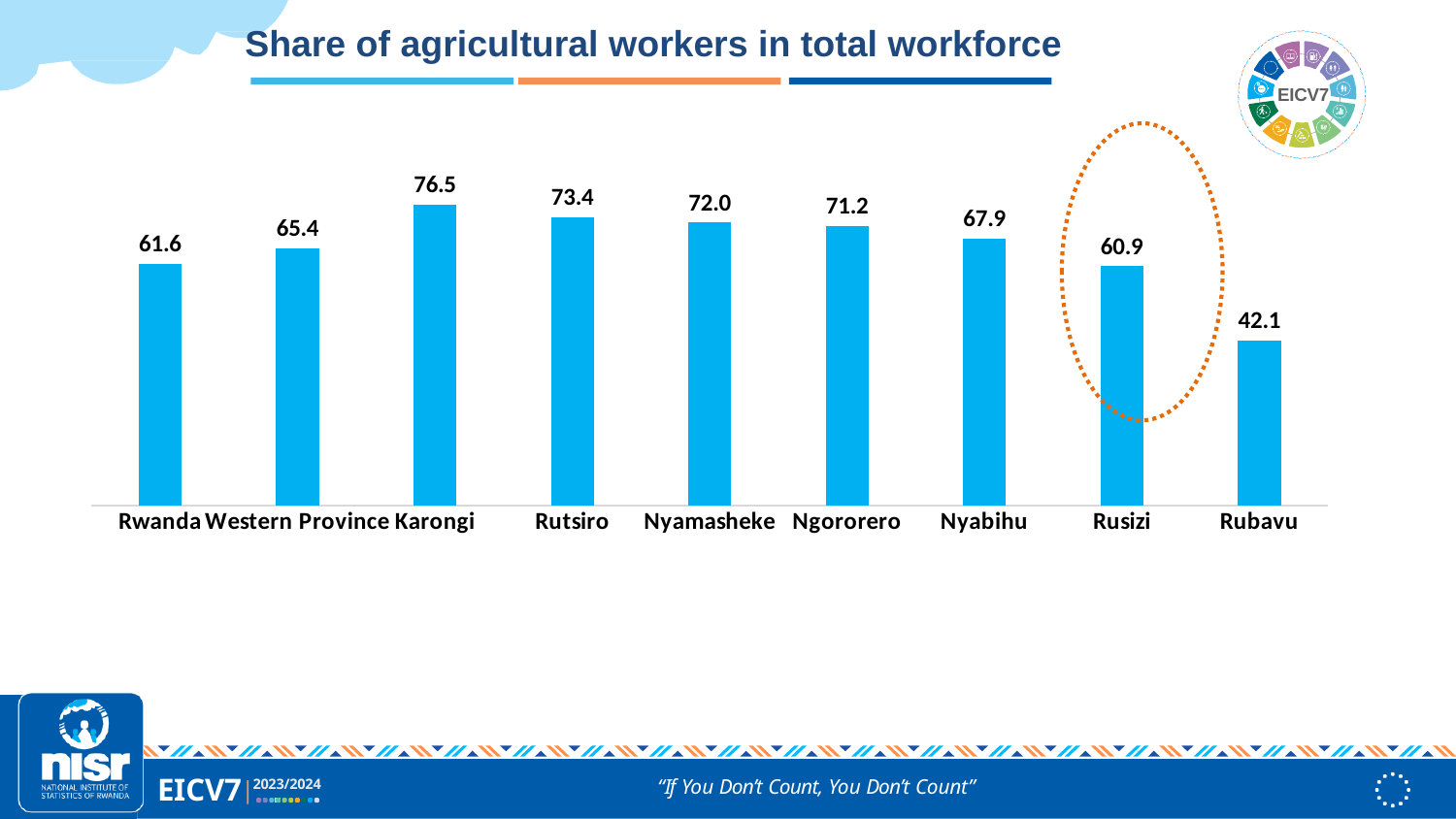
What kind of chart is shown on the slide? Bar chart What is the difference between the values for Western Province and Rwanda? 3.8 Which category has the lowest share of agricultural workers? Rubavu What is the share of agricultural workers in total workforce for Karongi? 76.5 Which is larger, the value for Nyabihu or the value for Rusizi? Nyabihu Which category has the highest share of agricultural workers? Karongi What is the value shown for Rwanda? 61.6 What is the difference between the values for Karongi and Rubavu? 34.4 What is the value shown for Rusizi? 60.9 How many categories are shown on the x axis? 9 What is the title of the chart? Share of agricultural workers in total workforce Which is larger, the value for Rutsiro or the value for Nyamasheke? Rutsiro